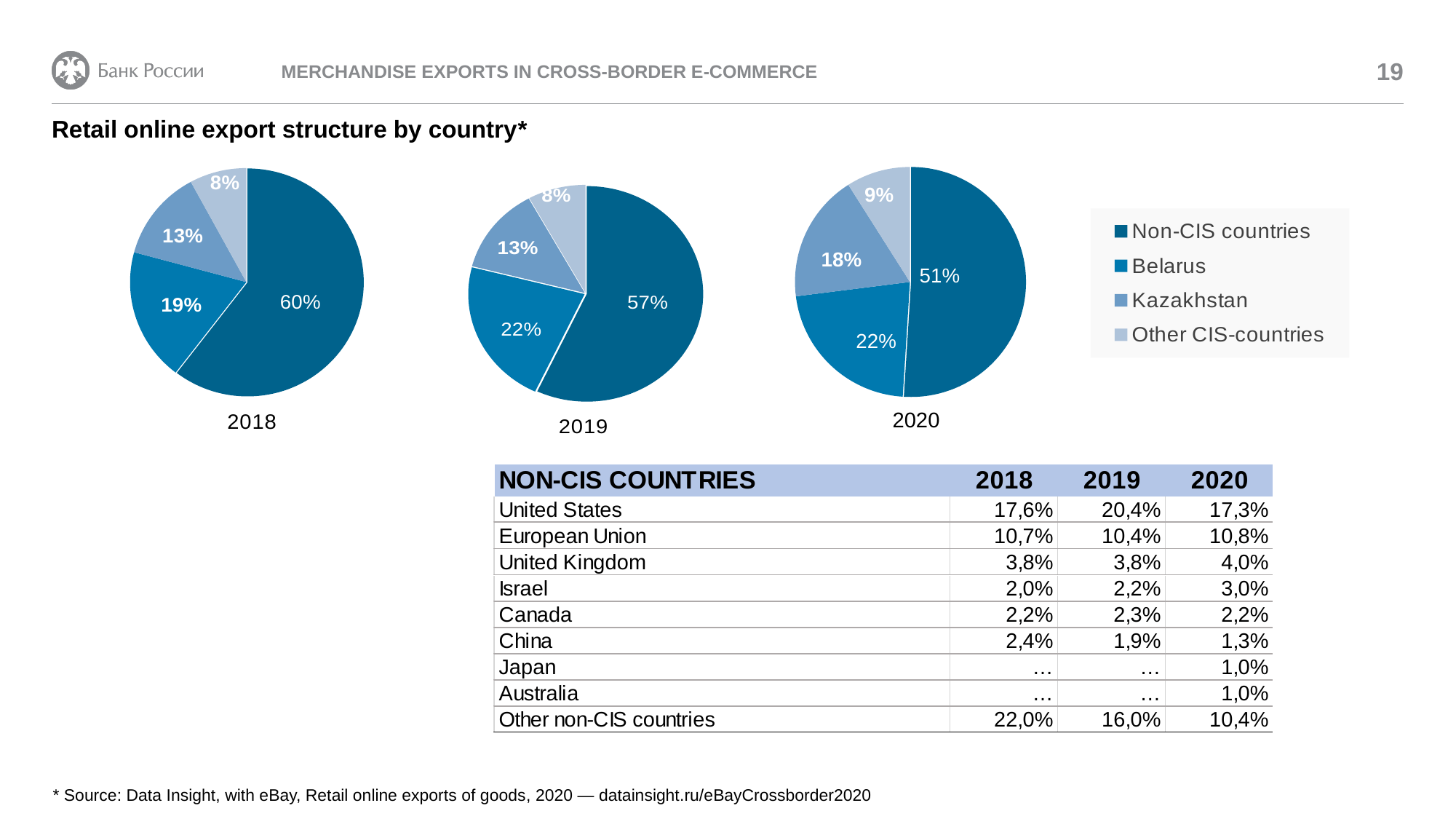
In the 2018 pie chart, what share do Non-CIS countries have? 60% In the 2020 pie chart, what is the share for Other CIS-countries? 9% In the 2019 pie chart, what is the difference between the Belarus share and the Kazakhstan share? 9 percentage points How many categories does the legend of the pie charts list? 4 In the 2020 pie chart, which category has the largest share? Non-CIS countries Is the Kazakhstan share larger in the 2018 pie chart or in the 2020 pie chart? 2020 By how many percentage points did the Non-CIS countries share fall from the 2018 pie chart to the 2020 pie chart? 9 percentage points What type of chart is used to show the retail online export structure by country? Pie chart In the 2018 pie chart, which category has the smallest share? Other CIS-countries How many slices does each pie chart have? 4 In the 2020 pie chart, what is the share for Kazakhstan? 18% In the 2019 pie chart, what is the share for Belarus? 22%